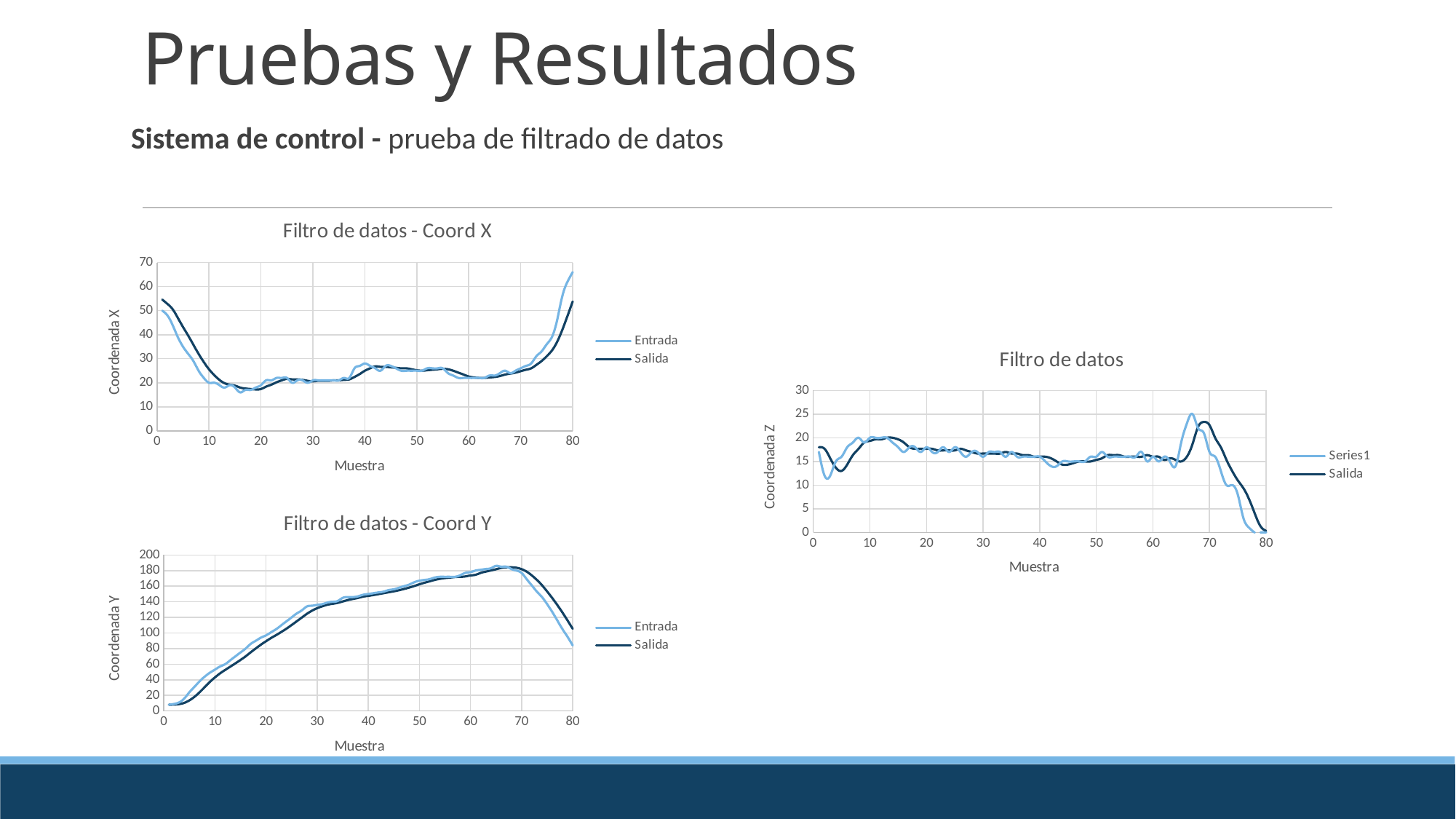
How many charts are shown on the slide? 3 In "Filtro de datos - Coord Y", is the Entrada value at Muestra 30 greater or less than 120? greater In "Filtro de datos - Coord X", is the Entrada value at Muestra 40 greater or less than 20? greater In "Filtro de datos - Coord Y", does the Entrada series rise or fall between Muestra 0 and Muestra 60? rise In "Filtro de datos - Coord Y", is the Entrada value at Muestra 80 greater or less than 100? less What kind of chart is "Filtro de datos - Coord X"? line chart What is the x-axis title of "Filtro de datos - Coord X"? Muestra In the chart titled "Filtro de datos" (right side), what are the two legend entries? Series1 and Salida How many series does the legend of "Filtro de datos - Coord Y" list? 2